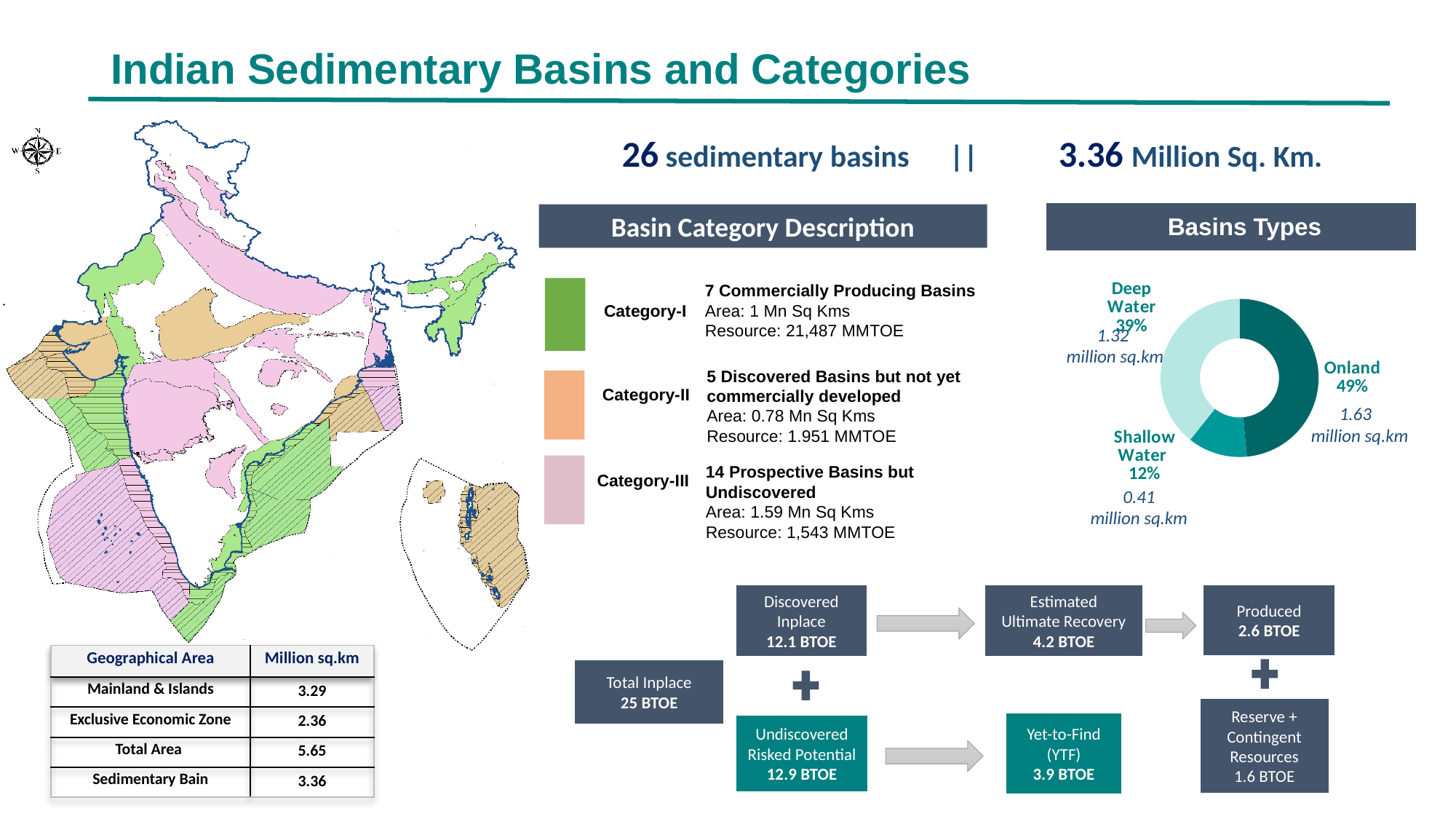
In the Basins Types chart, what percentage share does Deep Water have? 39% What is the title of the donut chart on the slide? Basins Types In the Basins Types chart, which basin type has the smallest share? Shallow Water In the Basins Types chart, what percentage share does Onland have? 49% In the Basins Types chart, which basin type has the largest share? Onland In the Basins Types chart, what area in million sq.km is given for Onland? 1.63 million sq.km What kind of chart is shown under the "Basins Types" heading? Donut (pie) chart How many basin types are shown in the Basins Types chart? 3 In the Basins Types chart, which has a larger share: Deep Water or Shallow Water? Deep Water In the Basins Types chart, what area in million sq.km is given for Deep Water? 1.32 million sq.km In the Basins Types chart, what is the difference in percentage points between the Onland and Deep Water shares? 10 percentage points In the Basins Types chart, what area in million sq.km is given for Shallow Water? 0.41 million sq.km